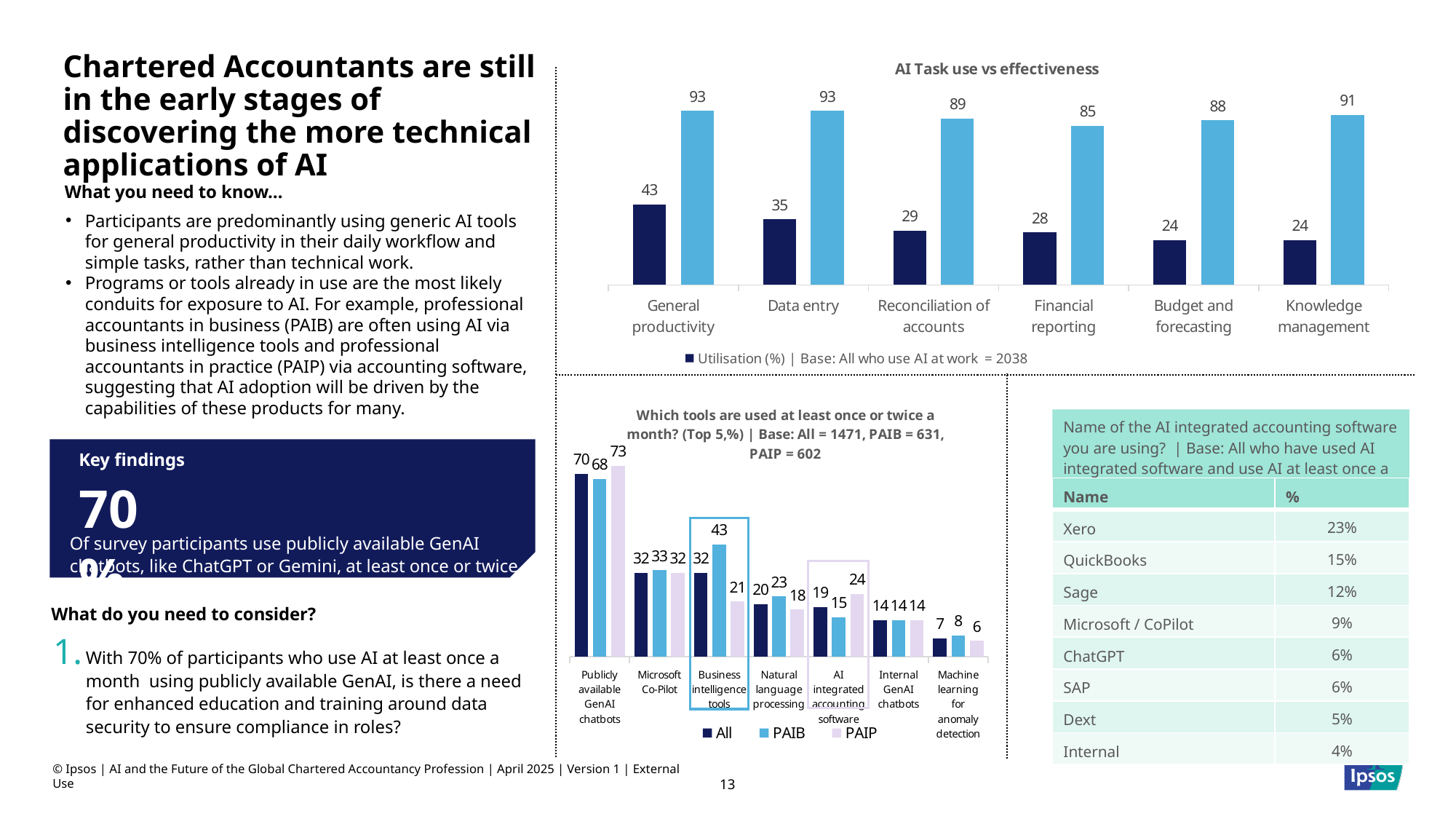
In the 'AI Task use vs effectiveness' chart, which category has the lowest Utilisation (%) value among the dark blue bars, Data entry or Financial reporting? Financial reporting In the 'Which tools are used at least once or twice a month?' chart, what is the difference between the PAIB and PAIP values for Business intelligence tools? 22 In the 'AI Task use vs effectiveness' chart, what is the value of the light blue bar for Financial reporting? 85 In the 'Which tools are used at least once or twice a month?' chart, which tool has the lowest value for All? Machine learning for anomaly detection In the 'AI Task use vs effectiveness' chart, which category has the highest Utilisation (%) value? General productivity In the 'Which tools are used at least once or twice a month?' chart, what is the PAIB value for Business intelligence tools? 43 In the 'Which tools are used at least once or twice a month?' chart, what is the PAIP value for AI integrated accounting software? 24 What kind of chart is 'Which tools are used at least once or twice a month?'? Bar chart In the 'Which tools are used at least once or twice a month?' chart, how many series does the legend list? 3 In the 'AI Task use vs effectiveness' chart, what is the difference between the Utilisation (%) values for General productivity and Data entry? 8 In the 'AI Task use vs effectiveness' chart, how many task categories are shown on the x axis? 6 In the 'AI Task use vs effectiveness' chart, what is the Utilisation (%) value for General productivity? 43